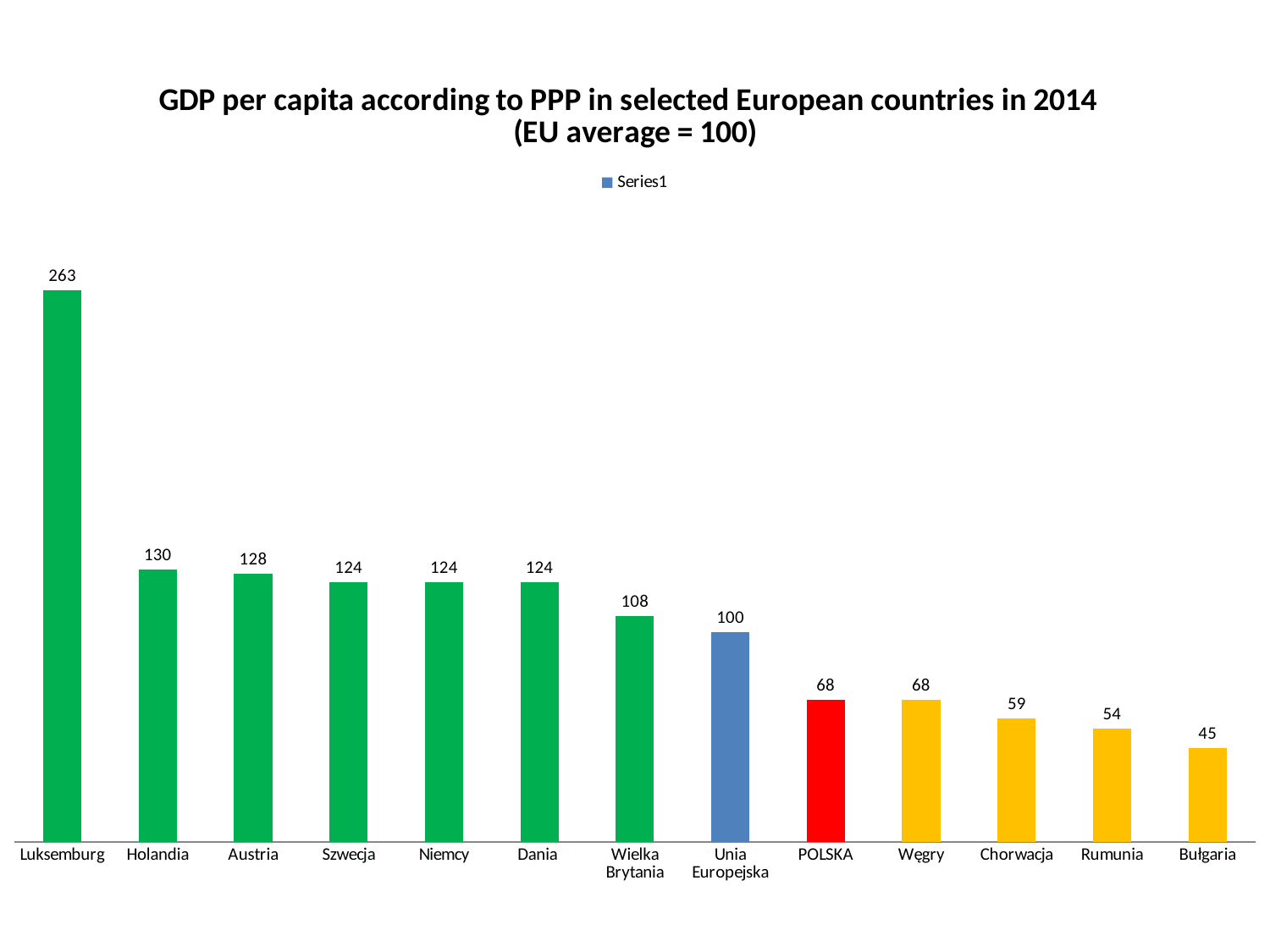
Which has a larger value, Chorwacja or Rumunia? Chorwacja What is the value for Wielka Brytania? 108 What is the value for Luksemburg? 263 Which country has the lowest value? Bułgaria Which country has the highest value? Luksemburg What is the value for POLSKA? 68 How many series does the legend list? 1 What colour is the bar for POLSKA? Red What is the difference between the values for Unia Europejska and Bułgaria? 55 How many countries or categories are shown on the x axis? 13 What kind of chart is shown on the slide? Bar chart What is the difference between the values for Holandia and POLSKA? 62